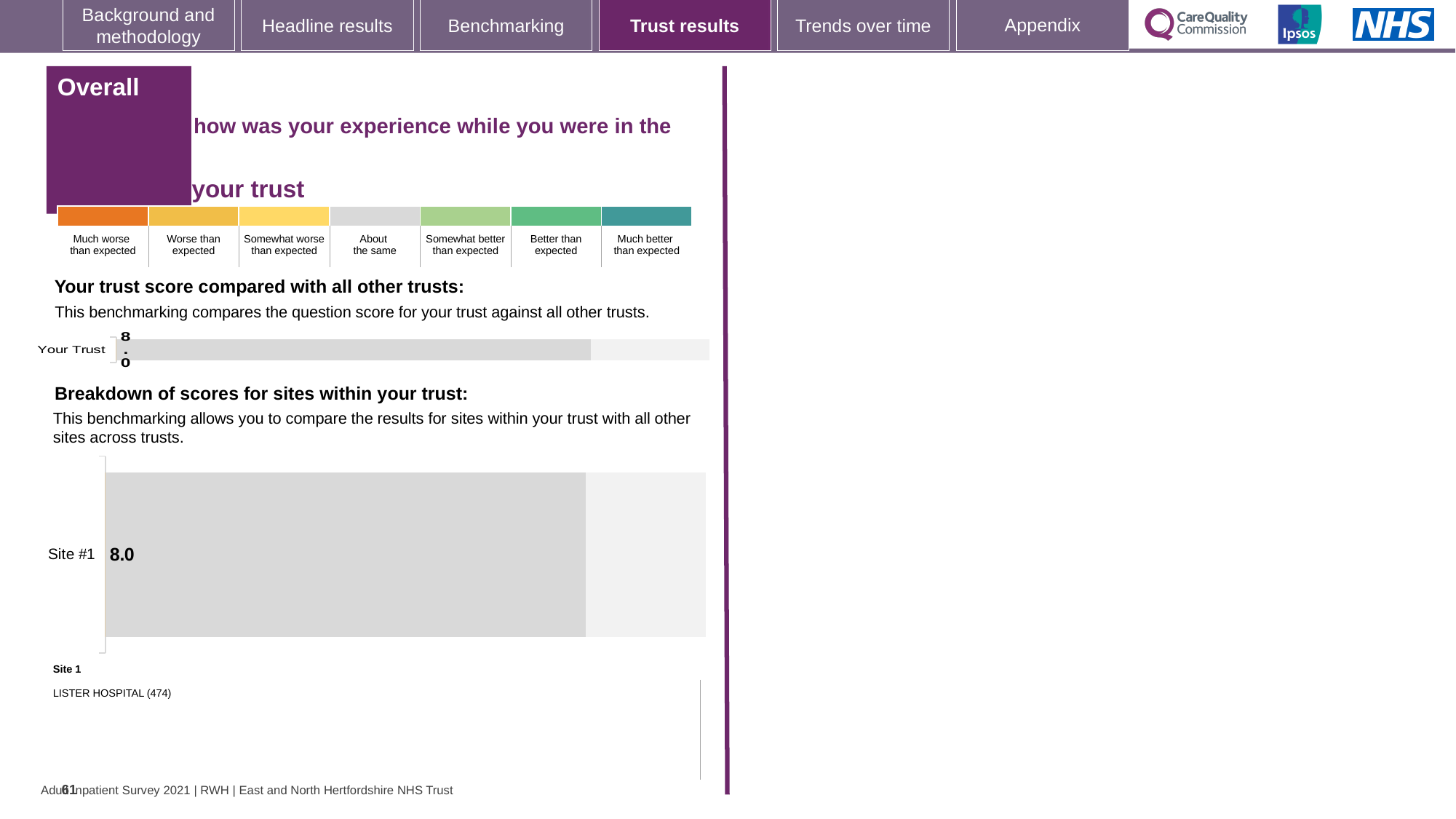
In the 'Your trust score compared with all other trusts' chart, what is the score for Your Trust? 8.0 How many bars are plotted in the 'Breakdown of scores for sites within your trust' chart? 1 How many rating categories does the colour scale above the charts show, from 'Much worse than expected' to 'Much better than expected'? 7 In the 'Breakdown of scores for sites within your trust' chart, which hospital is Site #1? LISTER HOSPITAL (474) How many bars are plotted in the 'Your trust score compared with all other trusts' chart? 1 What kind of chart is the 'Your trust score compared with all other trusts' chart? bar chart What kind of chart is the 'Breakdown of scores for sites within your trust' chart? bar chart In the 'Breakdown of scores for sites within your trust' chart, what is the score for Site #1? 8.0 What is the difference between the Your Trust score in the top chart and the Site #1 score in the bottom chart? 0.0